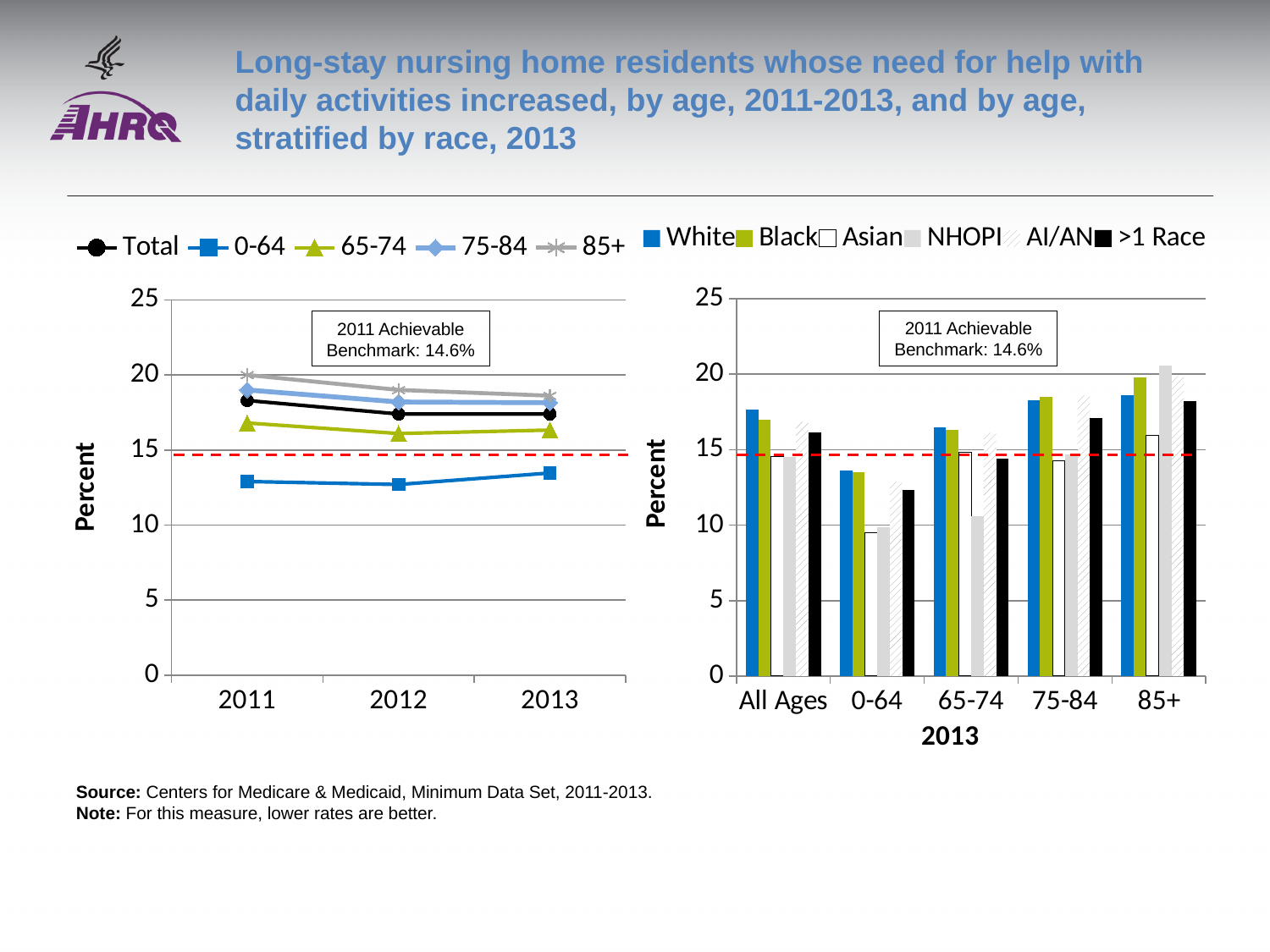
What is the 2011 Achievable Benchmark shown on the charts? 14.6% What type of chart is the left chart showing data by age for 2011-2013? line chart What type of chart is the right chart showing data by age stratified by race for 2013? bar chart In the right chart, how many age categories are shown on the x axis? 5 In the left chart, which age group has the lowest values across all years? 0-64 In the right chart, which race has the highest value in the 85+ group? NHOPI In the left chart, which age group has the highest values across all years? 85+ In the right chart, how many series does the legend list? 6 In the right chart, is the value for Asian in the 0-64 group greater or less than 10? less In the left chart, is the value for 0-64 in 2011 greater or less than 15? less In the left chart, does the 85+ line rise or fall from 2011 to 2013? fall In the left chart, how many series does the legend list? 5